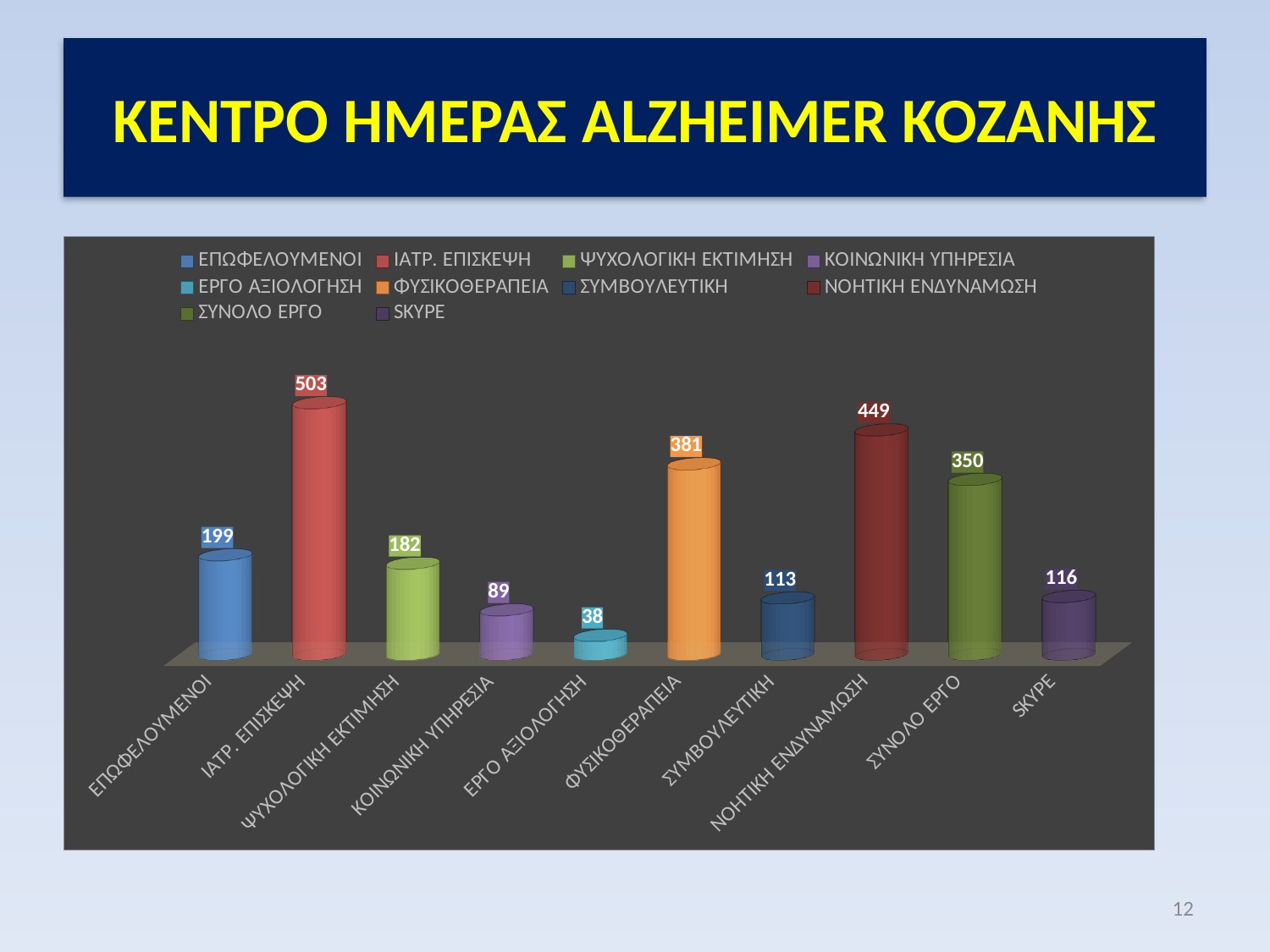
How many entries does the legend list? 10 How many categories are shown on the x axis of the chart? 10 Which is larger, the value for ΣΥΜΒΟΥΛΕΥΤΙΚΗ or the value for ΚΟΙΝΩΝΙΚΗ ΥΠΗΡΕΣΙΑ? ΣΥΜΒΟΥΛΕΥΤΙΚΗ What kind of chart is shown on the slide? Bar chart What is the value for ΦΥΣΙΚΟΘΕΡΑΠΕΙΑ? 381 What is the value for ΕΠΩΦΕΛΟΥΜΕΝΟΙ? 199 Which category has the highest value? ΙΑΤΡ. ΕΠΙΣΚΕΨΗ What is the difference between the values for ΣΥΝΟΛΟ ΕΡΓΟ and ΨΥΧΟΛΟΓΙΚΗ ΕΚΤΙΜΗΣΗ? 168 What is the value for SKYPE? 116 Which category has the lowest value? ΕΡΓΟ ΑΞΙΟΛΟΓΗΣΗ What is the difference between the values for ΙΑΤΡ. ΕΠΙΣΚΕΨΗ and ΝΟΗΤΙΚΗ ΕΝΔΥΝΑΜΩΣΗ? 54 What is the value for ΙΑΤΡ. ΕΠΙΣΚΕΨΗ? 503